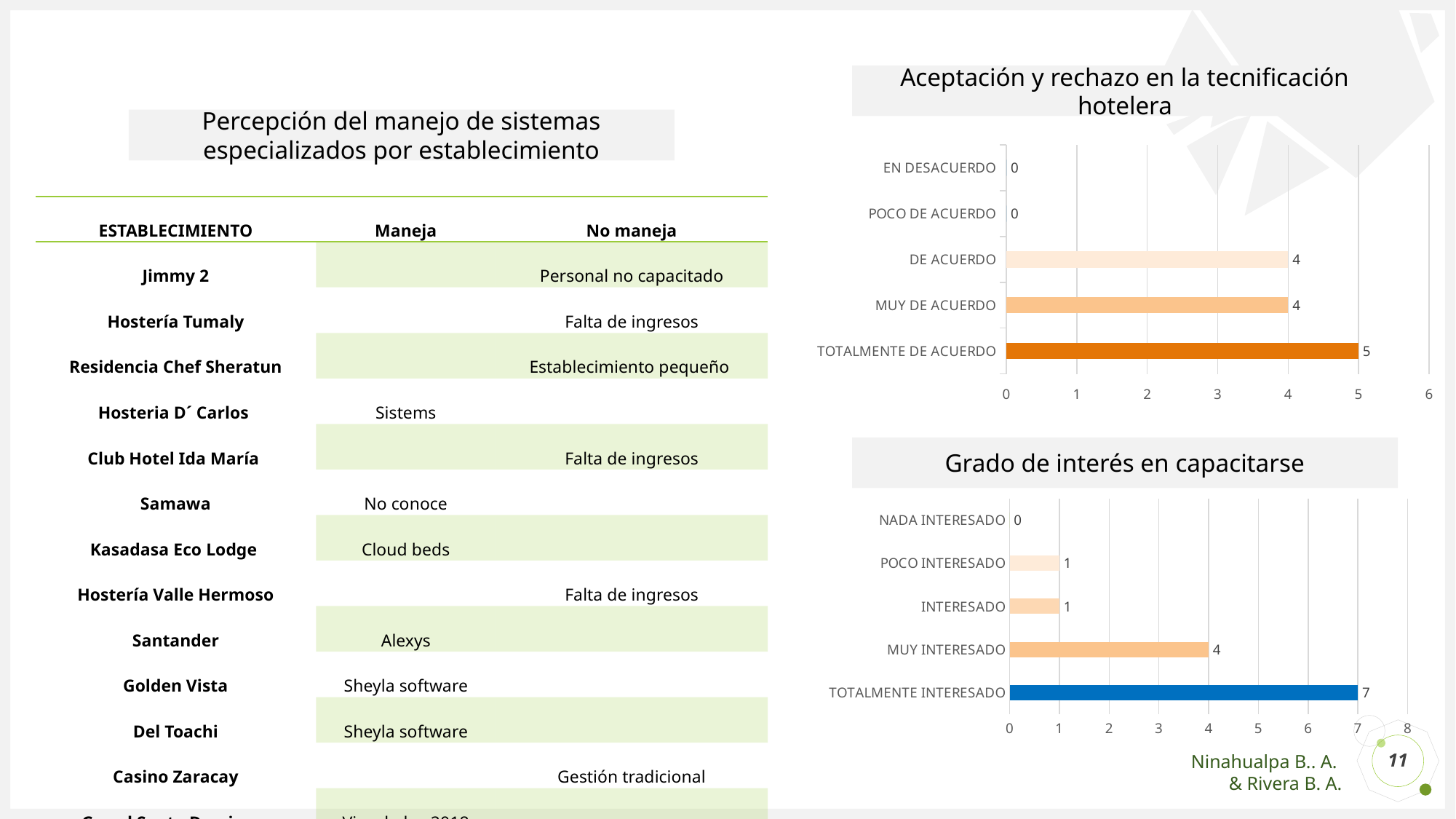
In the 'Aceptación y rechazo en la tecnificación hotelera' chart, how many categories are shown? 5 In the 'Grado de interés en capacitarse' chart, what is the highest value shown on the x axis? 8 In the 'Aceptación y rechazo en la tecnificación hotelera' chart, what is the difference between TOTALMENTE DE ACUERDO and MUY DE ACUERDO? 1 In the 'Grado de interés en capacitarse' chart, which is larger: TOTALMENTE INTERESADO or MUY INTERESADO? TOTALMENTE INTERESADO In the 'Aceptación y rechazo en la tecnificación hotelera' chart, what is the value for TOTALMENTE DE ACUERDO? 5 In the 'Grado de interés en capacitarse' chart, which category has the lowest value? NADA INTERESADO In the 'Aceptación y rechazo en la tecnificación hotelera' chart, which category has the highest value? TOTALMENTE DE ACUERDO In the 'Grado de interés en capacitarse' chart, what is the difference between TOTALMENTE INTERESADO and POCO INTERESADO? 6 In the 'Aceptación y rechazo en la tecnificación hotelera' chart, what is the value for DE ACUERDO? 4 In the 'Grado de interés en capacitarse' chart, what is the value for TOTALMENTE INTERESADO? 7 In the 'Grado de interés en capacitarse' chart, what is the value for MUY INTERESADO? 4 What kind of chart is 'Grado de interés en capacitarse'? Bar chart